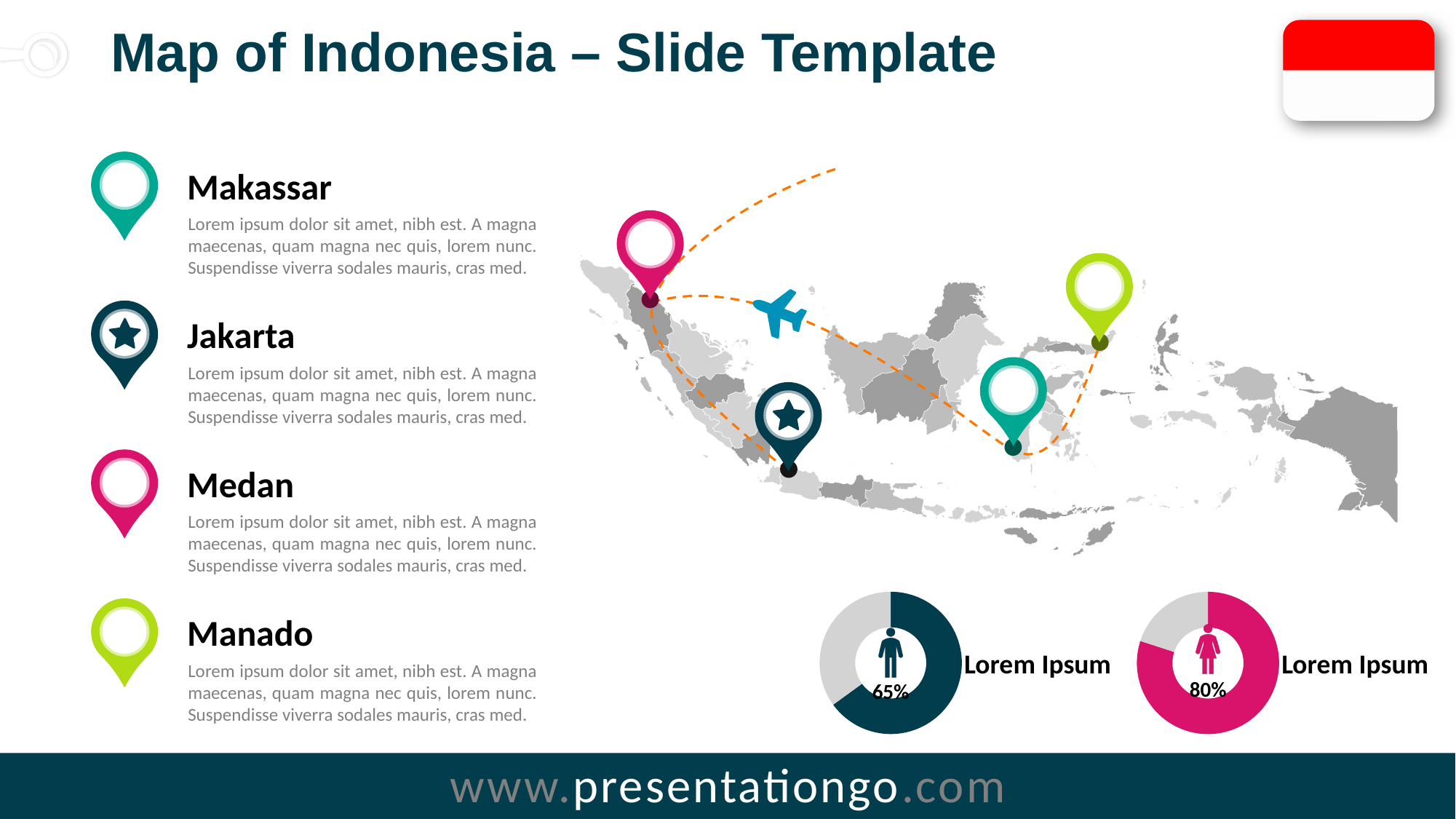
How many donut charts are shown on the slide? 2 What colour is the filled portion of the right donut chart with the female icon? Pink (magenta) What kind of chart is used to display the 65% and 80% values at the bottom right of the slide? Donut (pie) chart Which donut chart shows the larger percentage, the one with the male icon or the one with the female icon? The one with the female icon What percentage is shown in the left donut chart with the male figure icon? 65% What label appears next to the left donut chart with the male icon? Lorem Ipsum What is the difference in percentage points between the right donut chart (80%) and the left donut chart (65%)? 15 percentage points What percentage is shown in the right donut chart with the female figure icon? 80% Is the value in the left donut chart with the male icon greater or less than 50%? greater What share of the right donut chart with the female icon is left unfilled (grey)? 20% What share of the left donut chart with the male icon is left unfilled (grey)? 35%